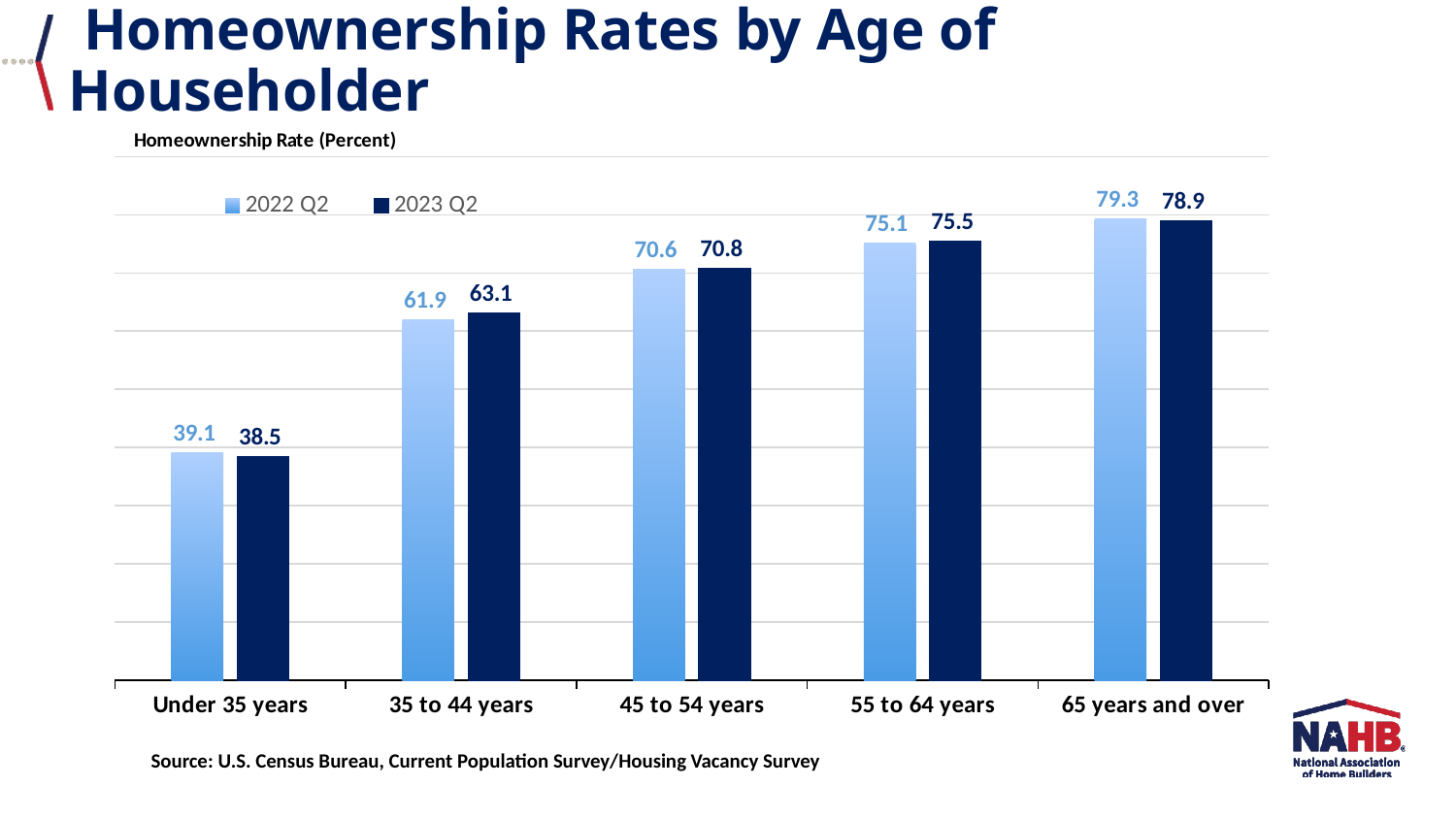
How many series does the legend list? 2 Which age group has the lowest 2023 Q2 homeownership rate? Under 35 years What is the difference between the 2023 Q2 and 2022 Q2 homeownership rates for the 35 to 44 years group? 1.2 For the 55 to 64 years group, which is larger: the 2022 Q2 rate or the 2023 Q2 rate? 2023 Q2 What is the 2023 Q2 homeownership rate for householders aged 35 to 44 years? 63.1 What is the 2023 Q2 homeownership rate for householders aged 65 years and over? 78.9 What is the 2022 Q2 homeownership rate for householders under 35 years? 39.1 Which age group has the highest 2022 Q2 homeownership rate? 65 years and over For the 65 years and over group, which is larger: the 2022 Q2 rate or the 2023 Q2 rate? 2022 Q2 Do the 2023 Q2 homeownership rates rise or fall as the age groups get older along the x axis? Rise How many age groups are shown on the x axis? 5 What kind of chart is shown on the slide? Bar chart